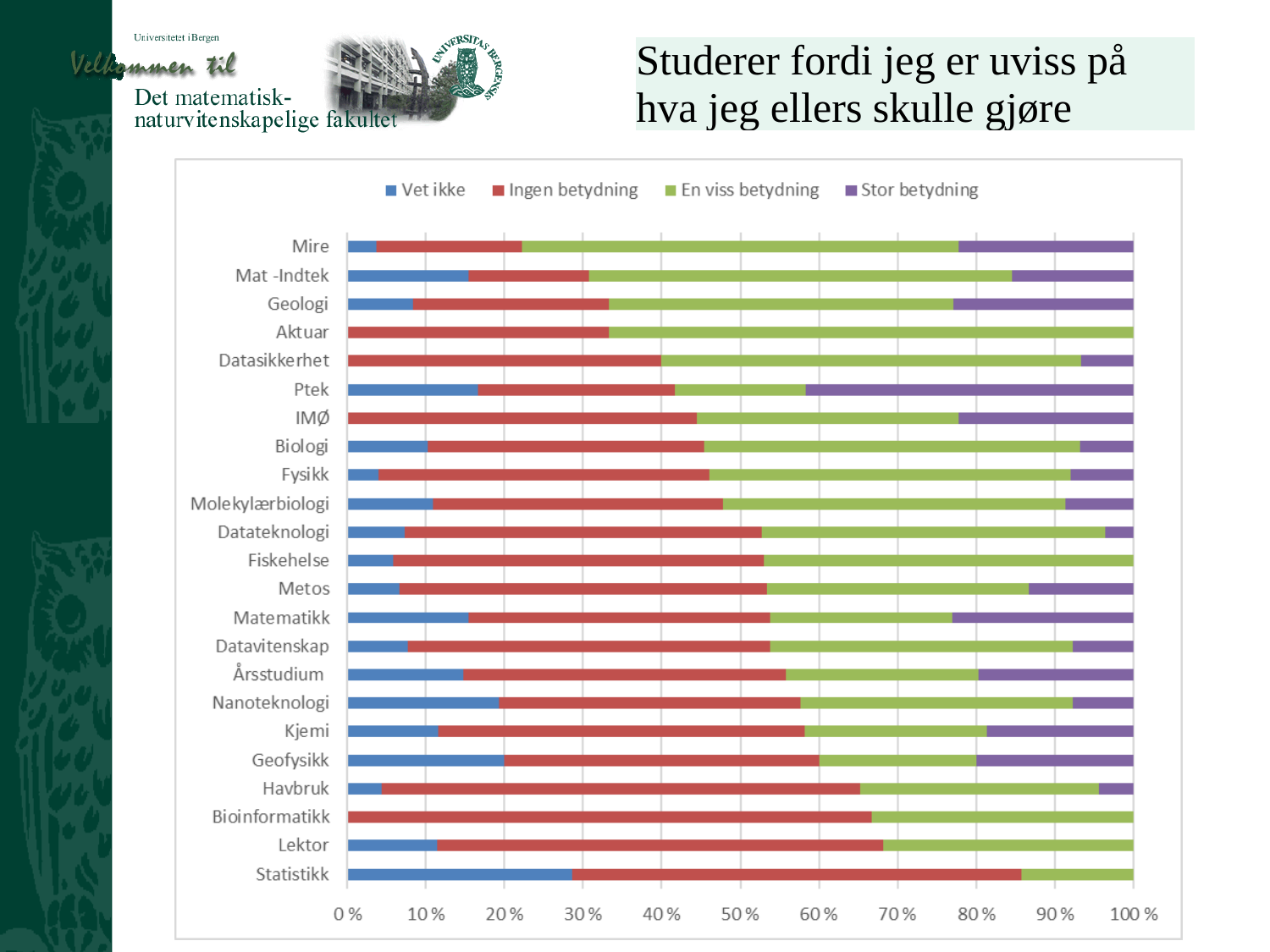
How many categories (study programmes) are plotted on the chart? 23 Is the 'Vet ikke' share for Statistikk greater or less than 20%? greater Is the 'Stor betydning' share for Ptek greater or less than 30%? greater What is the title of the slide above the chart? Studerer fordi jeg er uviss på hva jeg ellers skulle gjøre How many series does the legend list? 4 What kind of chart is shown on the slide? Stacked bar chart Is the 'Ingen betydning' share for Statistikk greater or less than 50%? greater Which category has the largest 'Vet ikke' share? Statistikk Which series is shown in green in the legend? En viss betydning Which has the larger 'Vet ikke' share, Statistikk or Mire? Statistikk Which category has the largest 'Stor betydning' share? Ptek